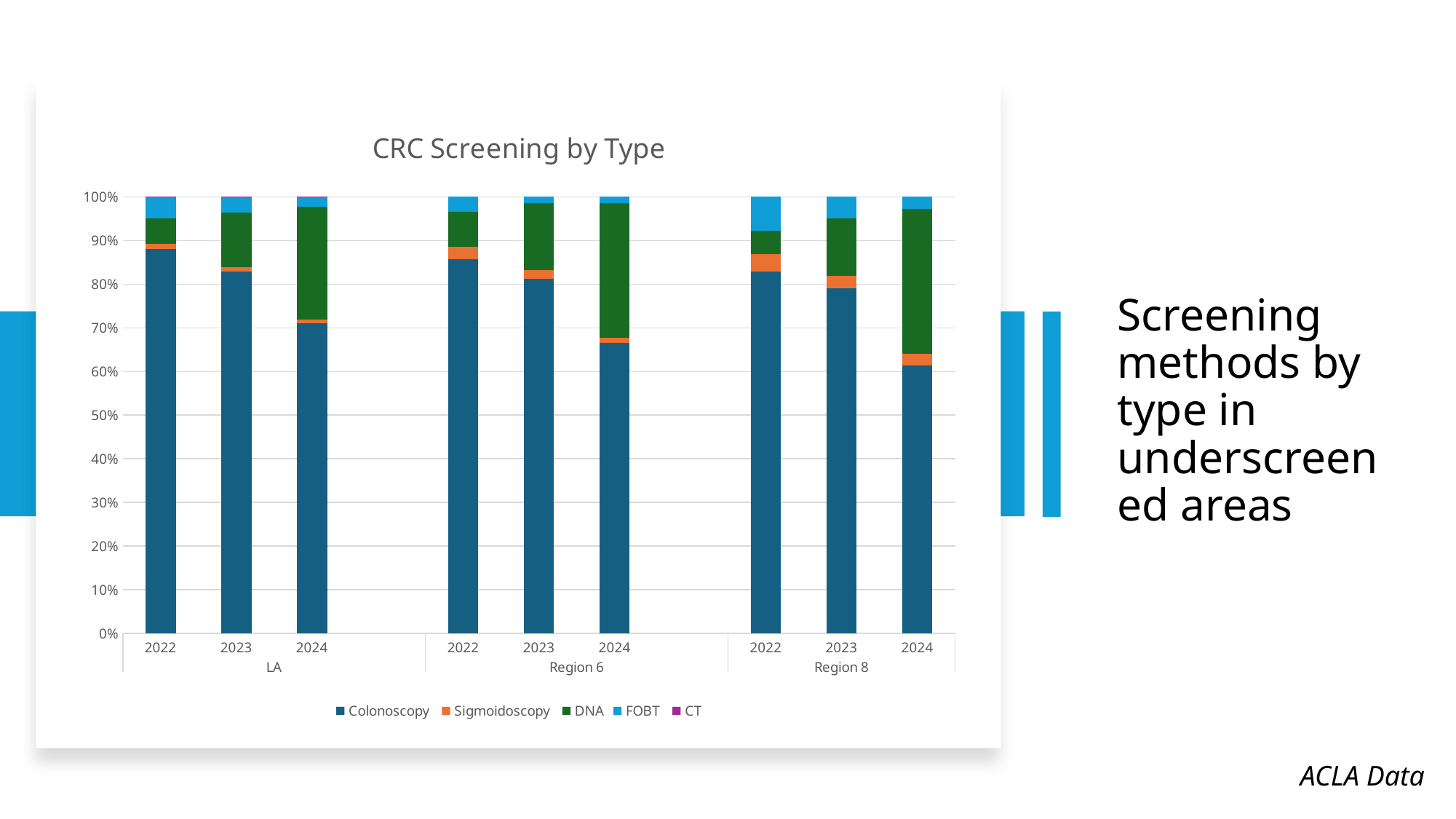
What is the title of the chart? CRC Screening by Type Is the Colonoscopy share for Region 8 in 2024 greater or less than 70%? less Is the Colonoscopy share for Region 6 in 2024 greater or less than 70%? less Which three areas are shown along the x axis? LA, Region 6, Region 8 How many stacked bars are plotted in the chart? 9 Is the Colonoscopy share for LA in 2022 greater or less than 80%? greater Which bar has the lowest Colonoscopy share? Region 8, 2024 Does the Colonoscopy share in Region 8 rise or fall from 2022 to 2024? fall Which is larger, the Colonoscopy share for LA in 2022 or for Region 8 in 2024? LA in 2022 What kind of chart is shown on the slide? Stacked bar chart How many series does the legend list? 5 Which screening types are listed in the legend? Colonoscopy, Sigmoidoscopy, DNA, FOBT, CT